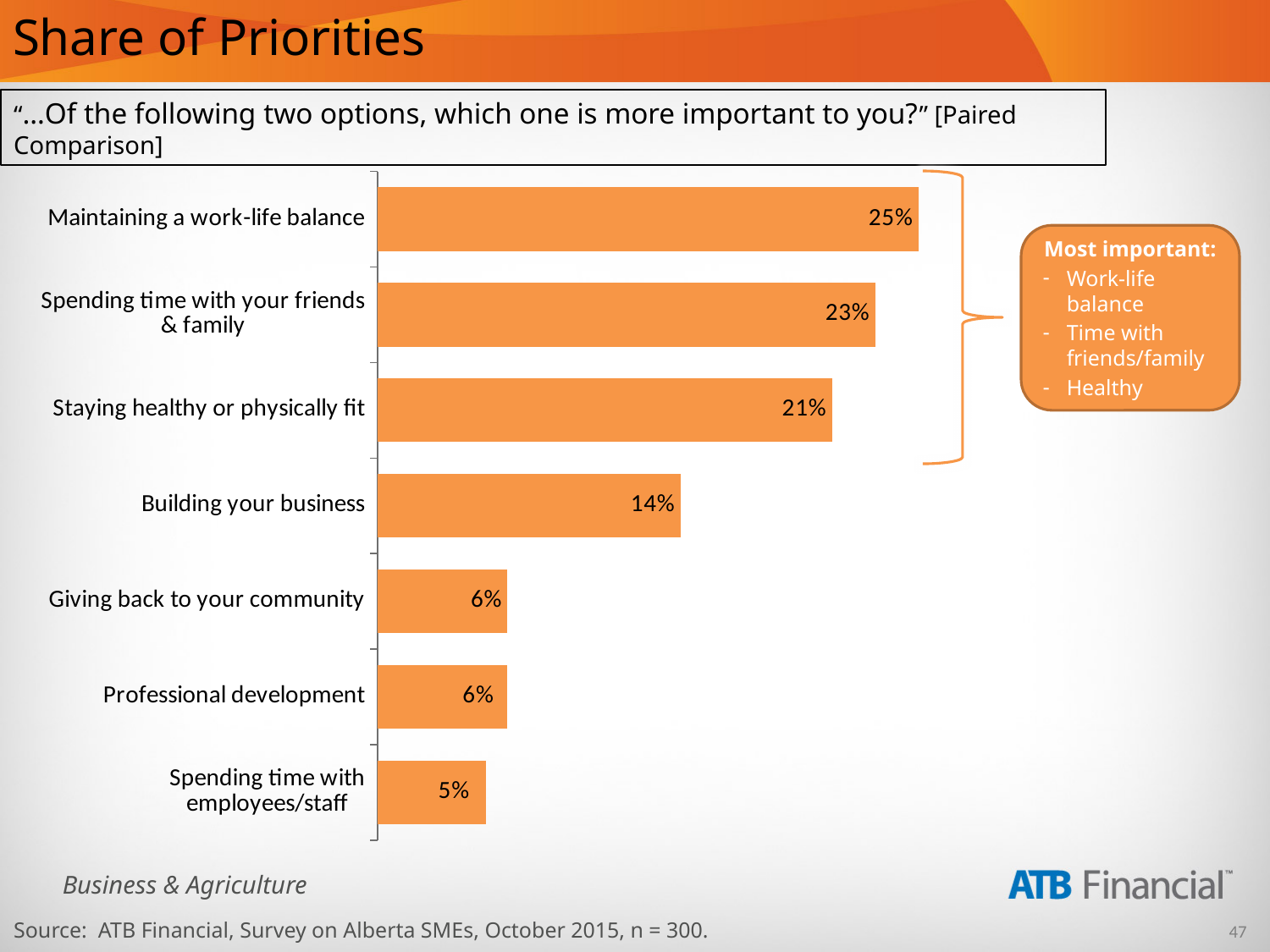
What kind of chart is shown on the slide? Bar chart What percentage is shown for Maintaining a work-life balance? 25% Which is larger: the value for Building your business or the value for Giving back to your community? Building your business What percentage is shown for Building your business? 14% How many categories are shown in the chart? 7 Which category has the highest value? Maintaining a work-life balance What percentage is shown for Spending time with employees/staff? 5% What is the difference between the values for Maintaining a work-life balance and Building your business? 11% What percentage is shown for Staying healthy or physically fit? 21% What is the title of the slide containing the chart? Share of Priorities Which category has the lowest value? Spending time with employees/staff What is the difference between the values for Spending time with your friends & family and Staying healthy or physically fit? 2%